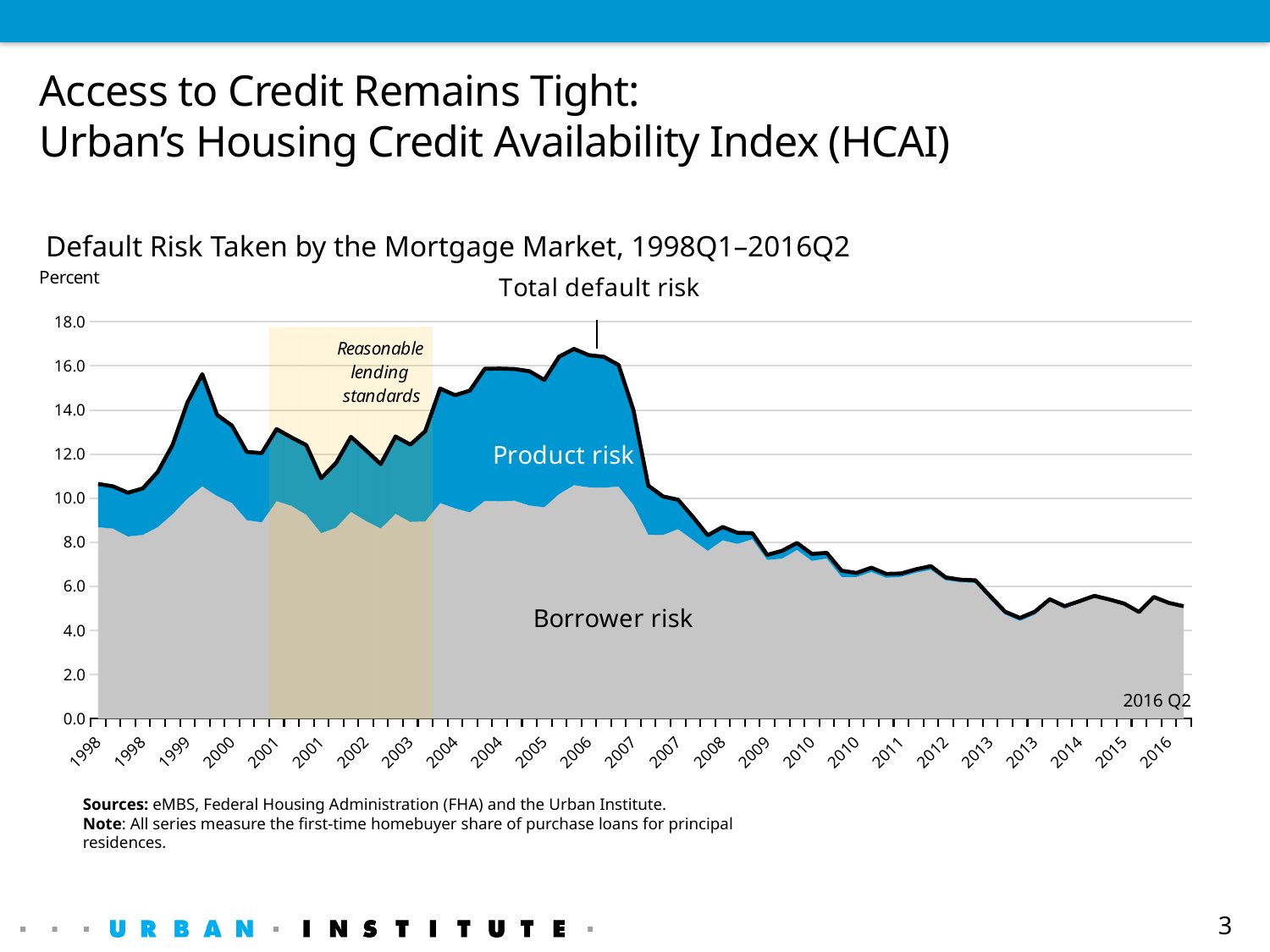
What is the title of the chart? Default Risk Taken by the Mortgage Market, 1998Q1–2016Q2 What kind of chart is shown on the slide? Stacked area chart How many series are plotted in the chart (Total default risk, Product risk, Borrower risk)? 3 Is the total default risk at 2016 Q2 greater or less than 6.0? less What label is shown in the shaded region around 2001–2003? Reasonable lending standards Around which year does the total default risk reach its highest point? 2006 Is the total default risk at its 2006 peak greater or less than 16.0? greater Which is larger, the total default risk in 2006 or in 2016? 2006 Is the total default risk at the start of 1998 greater or less than 10.0? greater Does the total default risk rise or fall from 2007 to 2016? fall